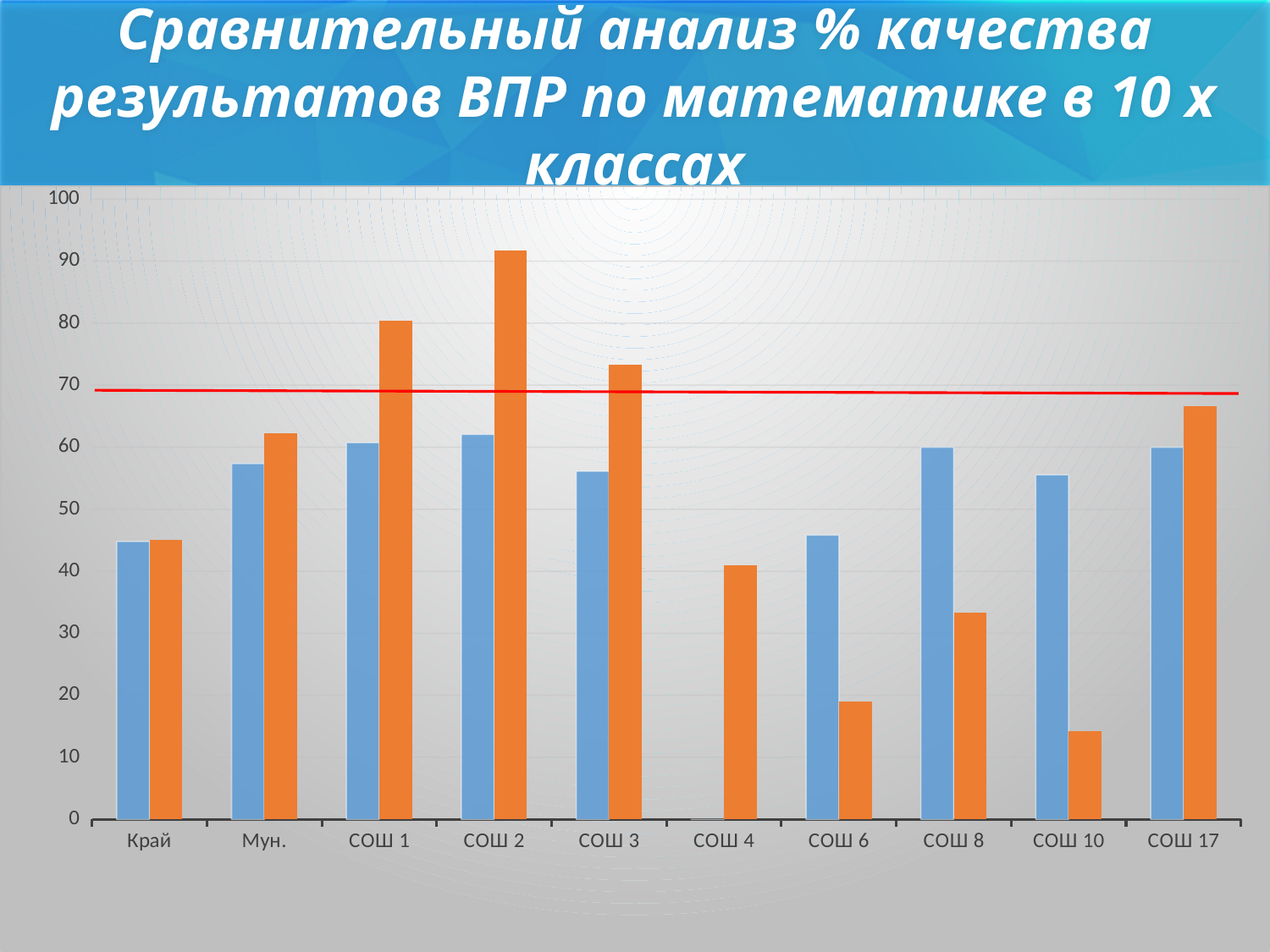
Which category has the highest orange bar? СОШ 2 Is the orange bar for СОШ 10 greater or less than 20? less Which category has the lowest orange bar? СОШ 10 Is the orange bar for СОШ 17 greater or less than 70? less Which category has the lowest blue bar? СОШ 4 Is the orange bar for СОШ 6 greater or less than 30? less How many categories are shown along the x axis? 10 For СОШ 6, which bar is taller, the blue one or the orange one? blue What kind of chart is shown on the slide? bar chart For СОШ 3, which bar is taller, the blue one or the orange one? orange